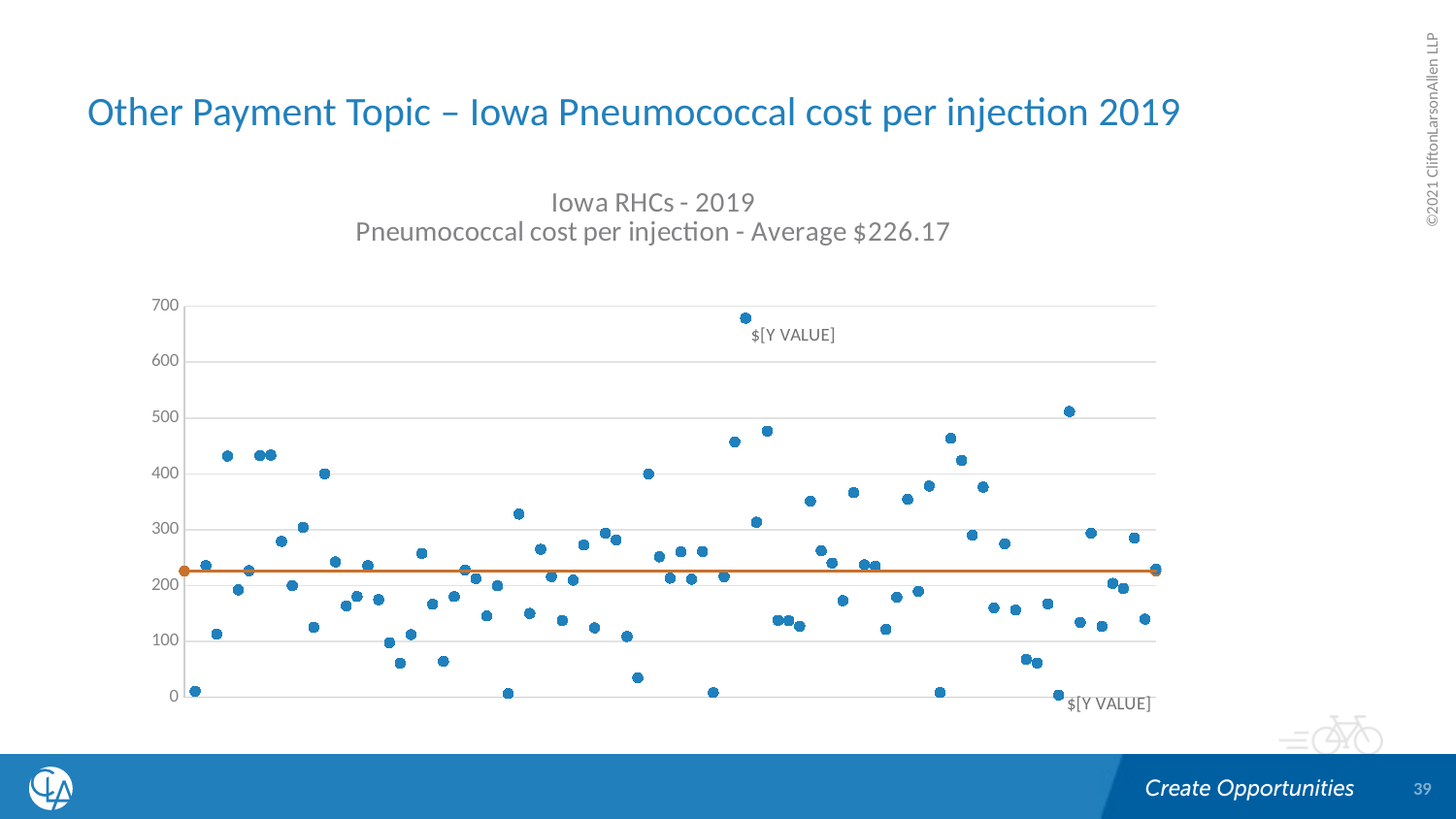
Is the value of the highest plotted point greater or less than 700? less What is the title of the chart? Iowa RHCs - 2019 Pneumococcal cost per injection - Average $226.17 According to the chart title, what is the average pneumococcal cost per injection? $226.17 Is the value of the highest plotted point greater or less than 600? greater Is the horizontal orange line plotted at a value greater or less than 300? less What kind of chart is shown on the slide? scatter chart What does the horizontal orange line across the chart represent? the average ($226.17)